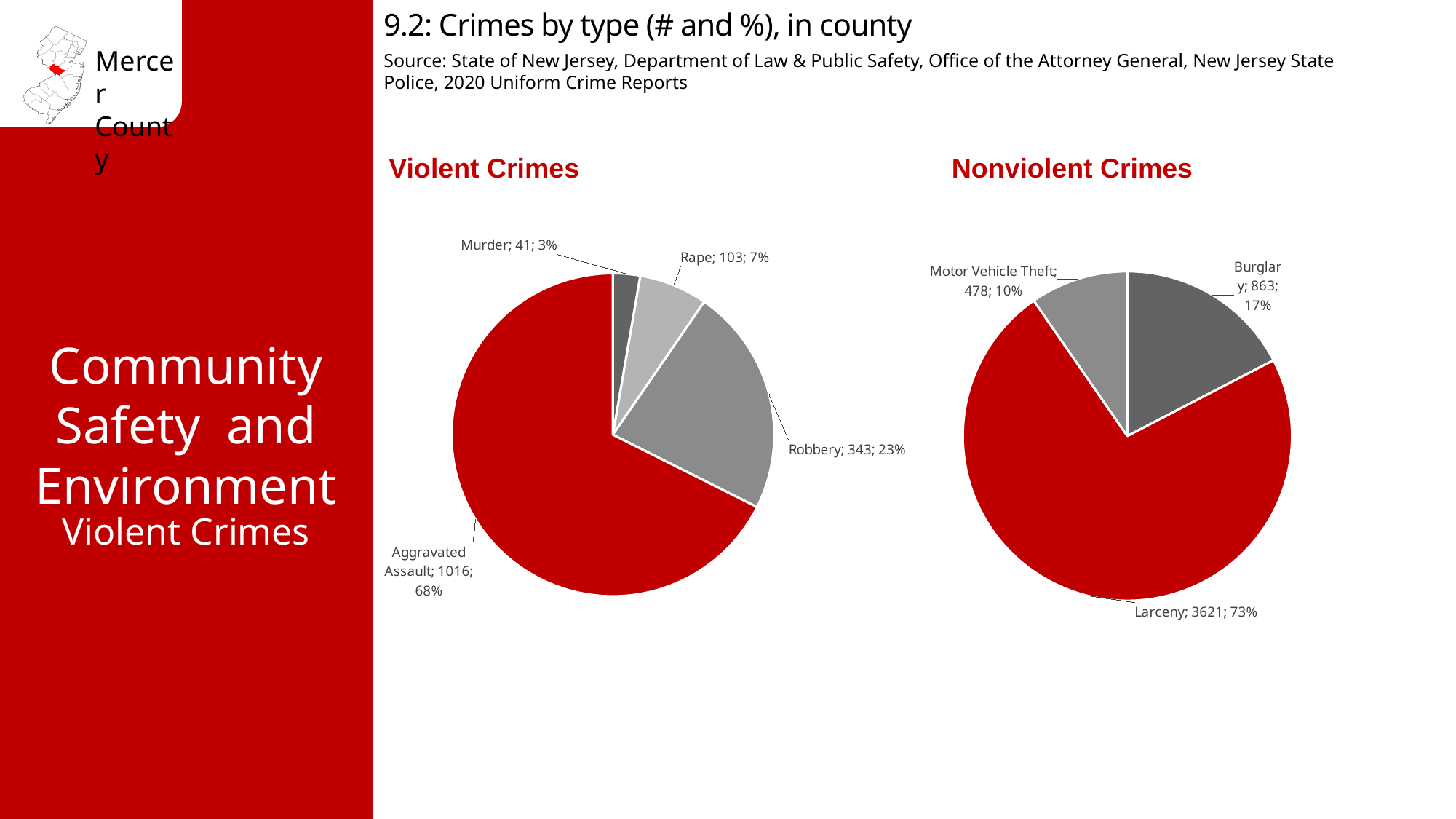
In the Nonviolent Crimes chart, how many larcenies are shown? 3621 In the Violent Crimes chart, which category has the largest slice? Aggravated Assault In the Nonviolent Crimes chart, which is larger, Motor Vehicle Theft or Burglary? Burglary In the Violent Crimes chart, what share of the pie is Robbery? 23% In the Violent Crimes chart, which category has the smallest slice? Murder In the Violent Crimes chart, how many aggravated assaults are shown? 1016 What kind of chart is the Nonviolent Crimes chart? Pie chart In the Nonviolent Crimes chart, how many categories are shown? 3 In the Nonviolent Crimes chart, what share of the pie is Burglary? 17% In the Violent Crimes chart, how many categories are shown? 4 In the Violent Crimes chart, what is the difference between the number of robberies and the number of rapes? 240 In the Nonviolent Crimes chart, what is the difference between the number of burglaries and the number of motor vehicle thefts? 385